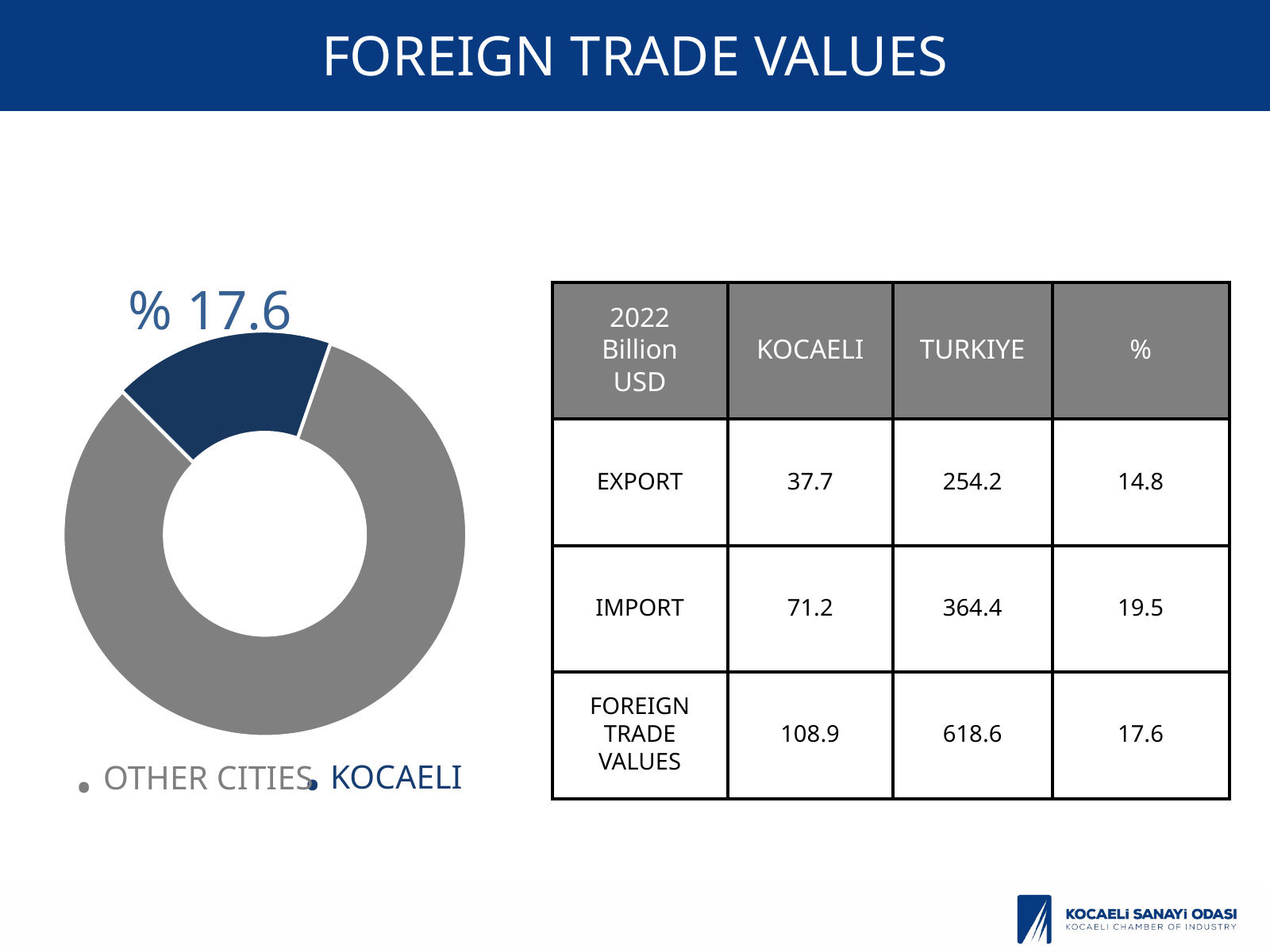
Which slice of the doughnut chart is the smallest? Kocaeli How many slices does the doughnut chart have? 2 What kind of chart is shown on the left of the slide? Doughnut (pie) chart In the doughnut chart, which is larger: the Other Cities slice or the Kocaeli slice? Other Cities What percentage share is labelled for Kocaeli in the doughnut chart? % 17.6 What is the title of the slide containing the doughnut chart? FOREIGN TRADE VALUES What colour is the Kocaeli slice in the doughnut chart? Dark blue How many entries does the legend of the doughnut chart list? 2 What are the two legend entries of the doughnut chart? Other Cities, Kocaeli Which slice of the doughnut chart is the largest? Other Cities